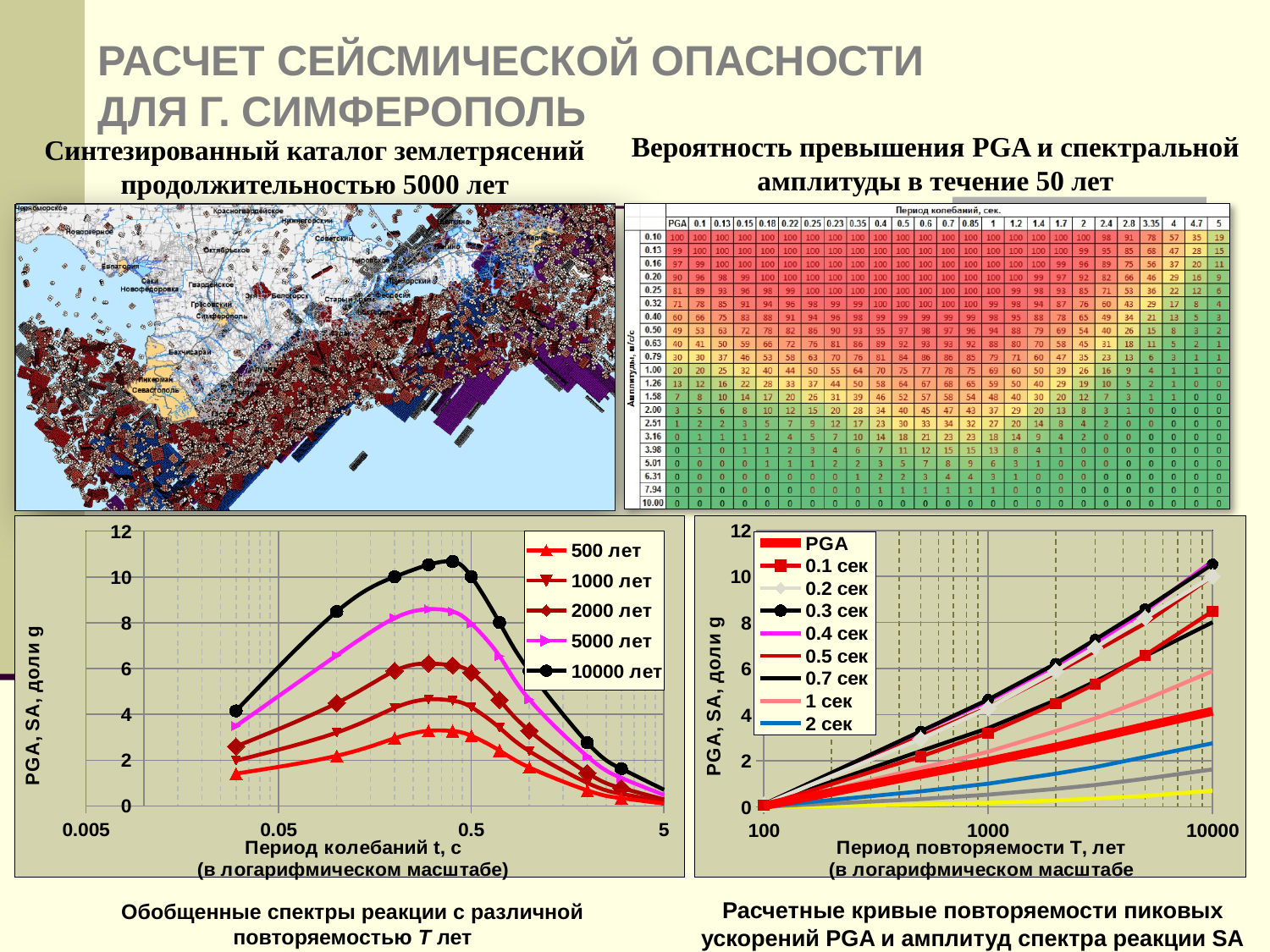
In the bottom-left chart (Обобщенные спектры реакции), is the peak value of the 10000 лет series greater or less than 10? greater In the bottom-left chart (Обобщенные спектры реакции), what is the label of the y axis? PGA, SA, доли g In the bottom-right chart (Расчетные кривые повторяемости), do the values rise or fall as the return period T increases? rise In the bottom-right chart (Расчетные кривые повторяемости), is the value of the 2 сек series at T = 10000 greater or less than 4? less In the bottom-left chart (Обобщенные спектры реакции), what kind of chart is it? line chart In the bottom-right chart (Расчетные кривые повторяемости), which is larger at T = 10000: the PGA series or the 0.3 сек series? 0.3 сек In the bottom-left chart (Обобщенные спектры реакции), how many series does the legend list? 5 In the bottom-right chart (Расчетные кривые повторяемости), is the value of the 0.3 сек series at T = 10000 greater or less than 10? greater In the bottom-right chart (Расчетные кривые повторяемости), how many series does the legend list? 9 In the bottom-left chart (Обобщенные спектры реакции), which series reaches the highest peak value? 10000 лет In the bottom-left chart (Обобщенные спектры реакции), which series has the lowest peak value? 500 лет